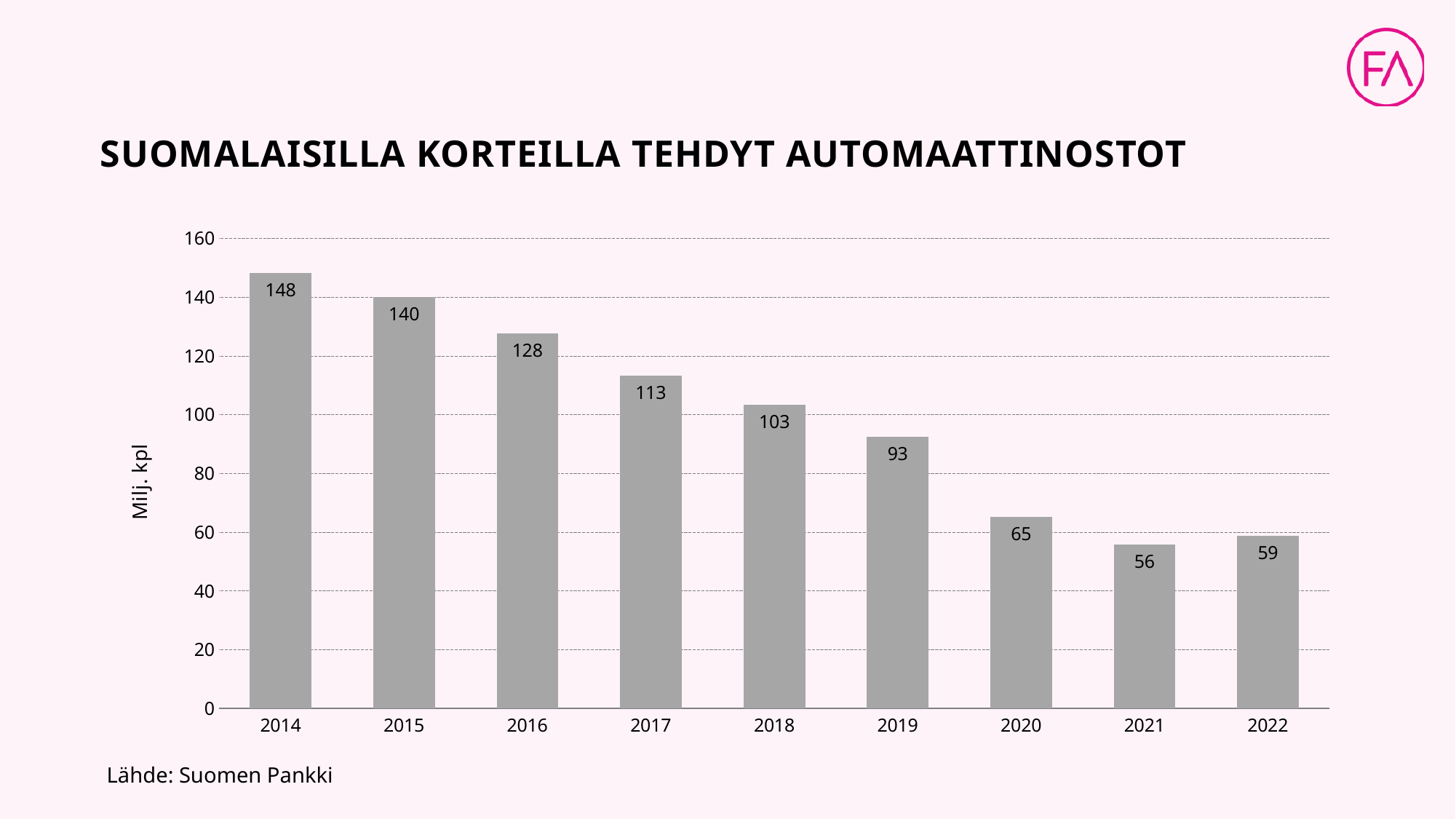
Do the values generally rise or fall from 2014 to 2022? fall Which is larger, the value for 2021 or the value for 2022? 2022 What is the difference between the values for 2014 and 2022? 89 What is the value for 2019? 93 How many years are shown on the x axis? 9 What kind of chart is this? bar chart Which year has the lowest value? 2021 What is the label on the vertical axis? Milj. kpl What is the value for 2014? 148 What is the value for 2022? 59 Which year has the highest value? 2014 What is the difference between the values for 2017 and 2018? 10